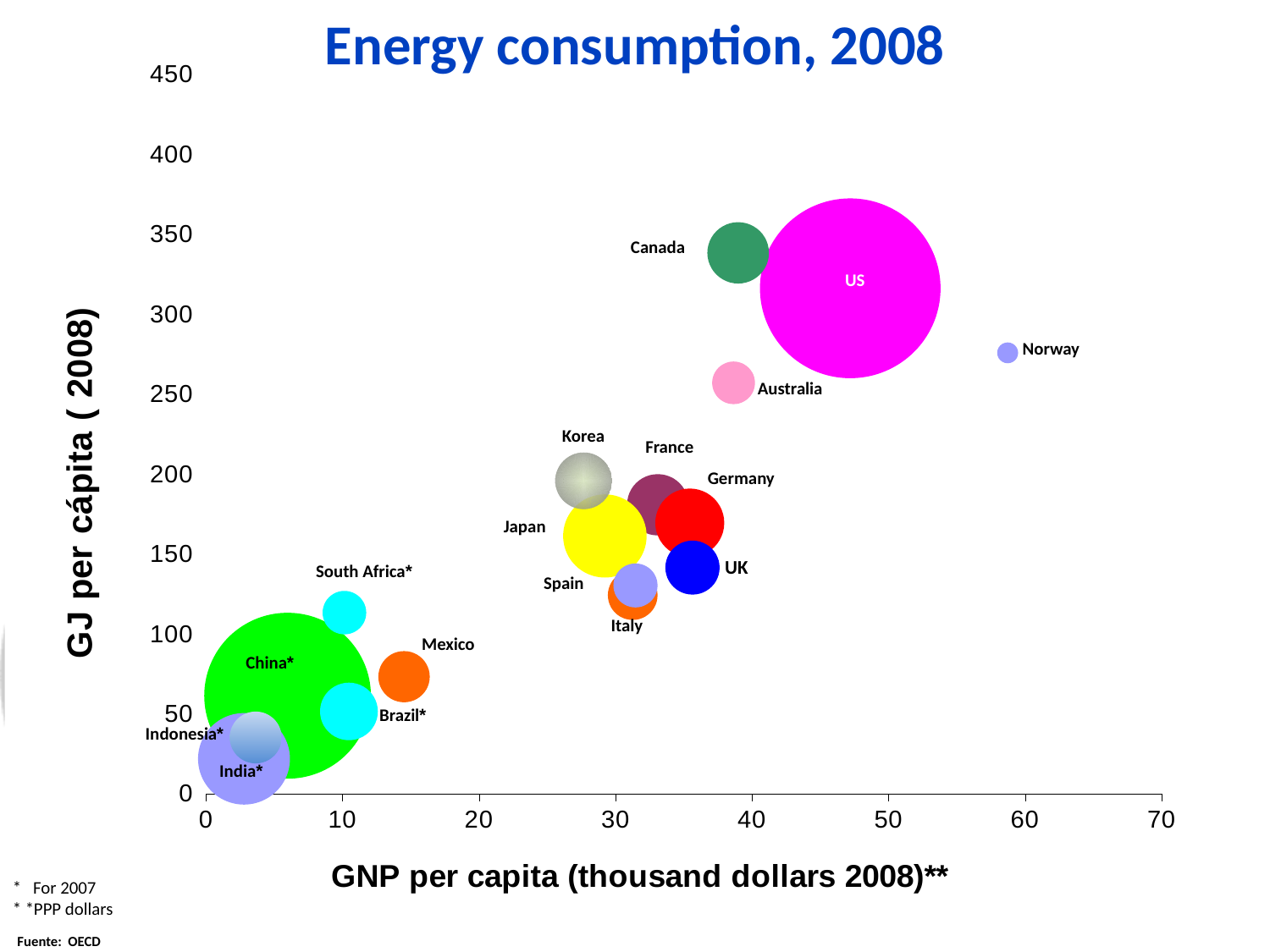
Is the GJ per capita value for Norway greater or less than 300? less Is the GJ per capita value for Mexico greater or less than 100? less Is the GNP per capita value for China* greater or less than 10? less What kind of chart is shown on the slide? bubble chart What is the label of the horizontal axis? GNP per capita (thousand dollars 2008)** What is the title of the chart? Energy consumption, 2008 Which has the higher GNP per capita, Germany or Japan? Germany Which country has the lowest GJ per capita on the chart? India* Which country has the highest GNP per capita on the chart? Norway Which has the higher GJ per capita, Canada or Australia? Canada How many countries are plotted as bubbles on the chart? 17